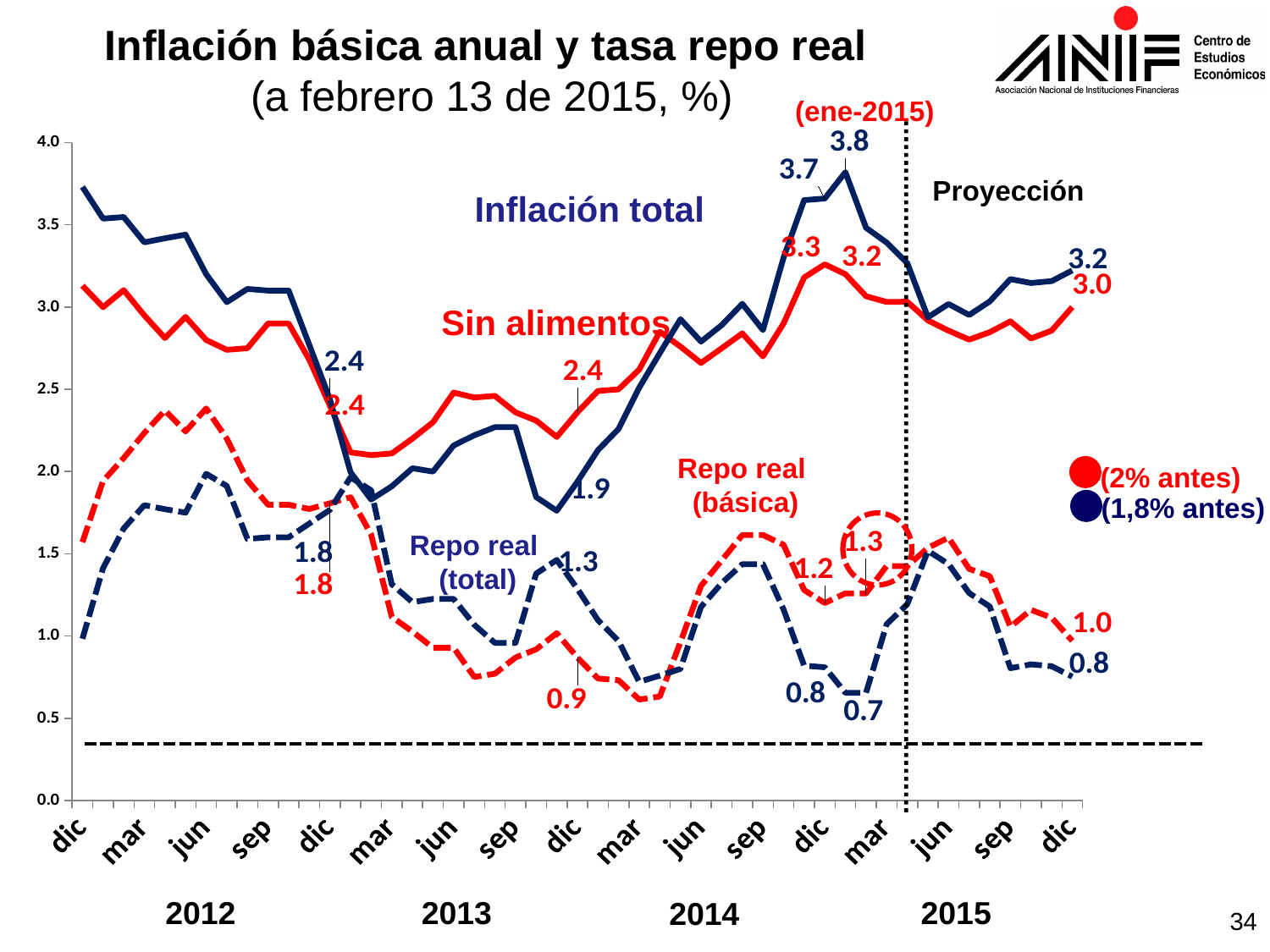
What is the projected value of Repo real (básica) at dic 2015? 1.0 At the dic 2015 projection, which is higher: Repo real (básica) or Repo real (total)? Repo real (básica) What label appears to the right of the vertical dotted line on the chart? Proyección Does Inflación total rise or fall between dic 2011 and dic 2012? fall What is the peak value of Inflación total labelled at ene-2015? 3.8 Is the value of Inflación total at the start of the chart (dic 2011) greater or less than 3.5? greater What is the projected value of Sin alimentos at dic 2015? 3.0 Which series reaches the highest value on the chart? Inflación total What is the projected value of Repo real (total) at dic 2015? 0.8 What is the projected value of Inflación total at dic 2015? 3.2 What kind of chart is shown on the slide? line chart What is the difference between the projected dic 2015 values of Inflación total (3.2) and Sin alimentos (3.0)? 0.2